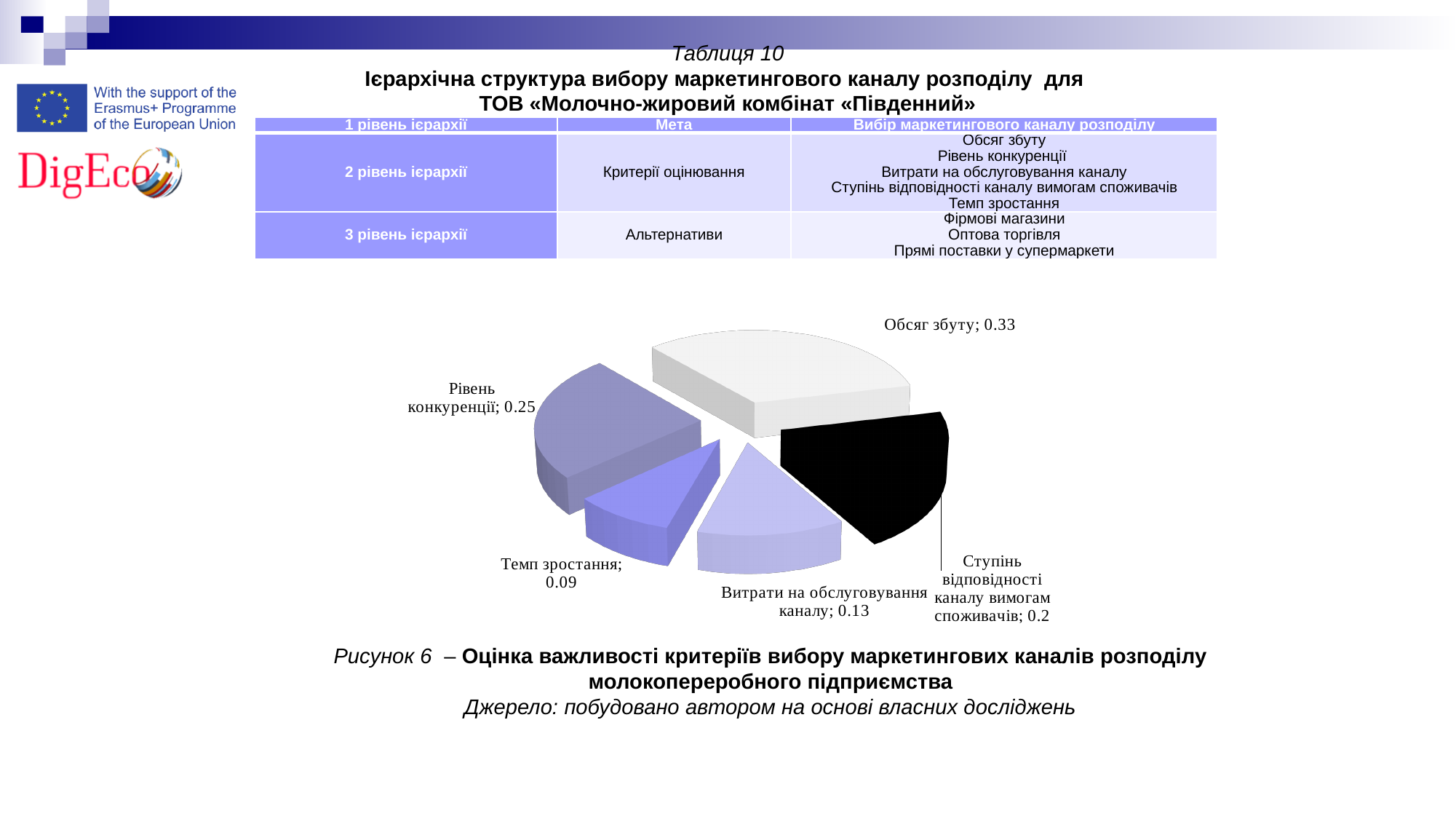
What is the value for Витрати на обслуговування каналу in the pie chart? 0.13 How many slices does the pie chart have? 5 Which criterion has the smallest slice in the pie chart? Темп зростання What is the value for Ступінь відповідності каналу вимогам споживачів in the pie chart? 0.2 Which criterion has the largest slice in the pie chart? Обсяг збуту What is the value for Обсяг збуту in the pie chart? 0.33 What is the value for Темп зростання in the pie chart? 0.09 What is the difference between the values for Обсяг збуту and Рівень конкуренції? 0.08 Which is larger: the value for Витрати на обслуговування каналу or the value for Темп зростання? Витрати на обслуговування каналу What colour is the slice for Ступінь відповідності каналу вимогам споживачів? black What type of chart is shown on the slide? pie chart What is the value for Рівень конкуренції in the pie chart? 0.25